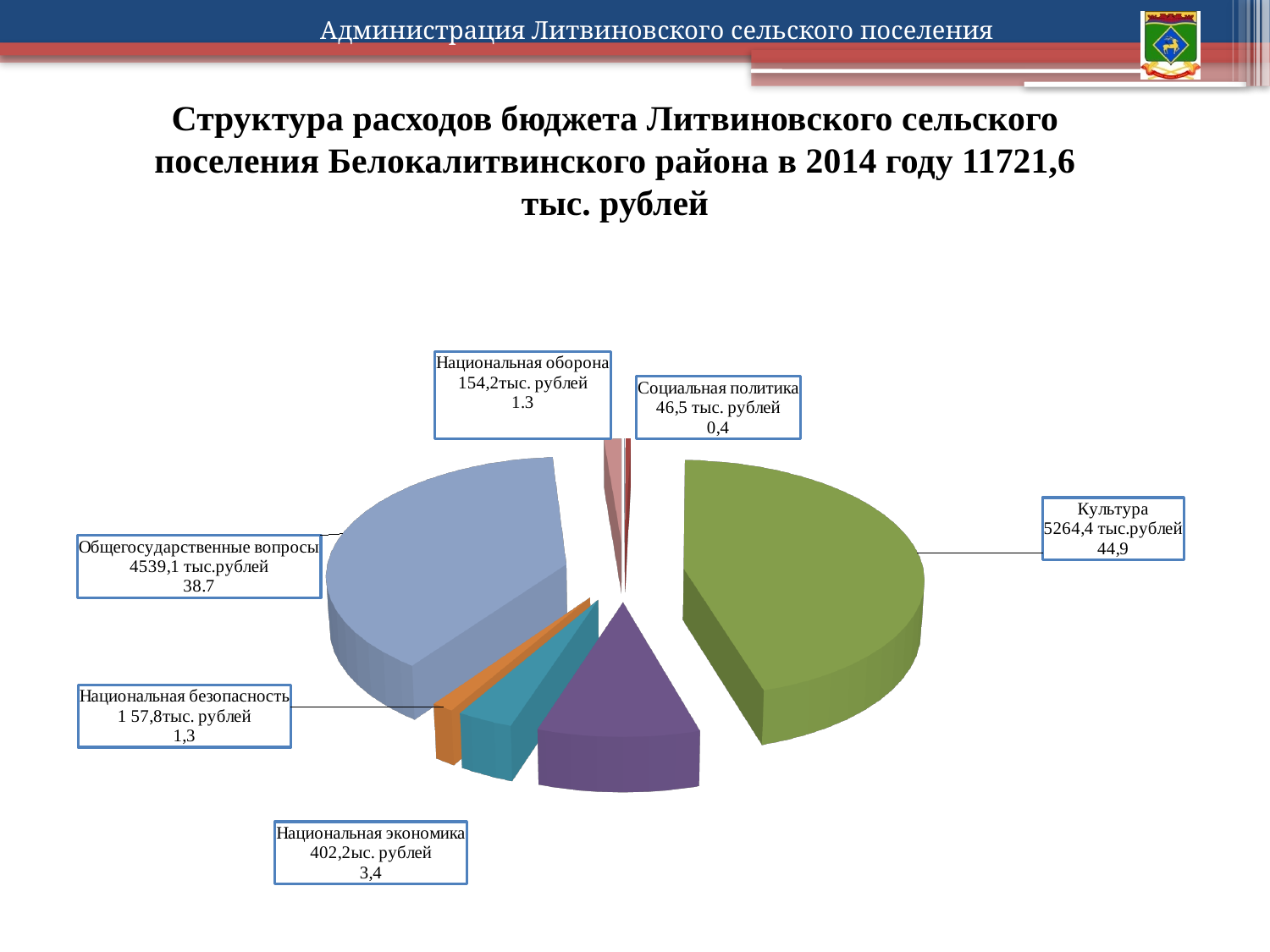
What is the value for Культура? 5264,4 тыс.рублей What kind of chart is shown on the slide? pie chart What is the value for Общегосударственные вопросы? 4539,1 тыс.рублей What share of the pie does Культура represent? 44,9 What is the value for Социальная политика? 46,5 тыс. рублей Which labelled category has the smallest value? Социальная политика What is the value for Национальная экономика? 402,2 тыс. рублей What is the difference between the values for Культура and Общегосударственные вопросы? 725,3 тыс.рублей What share of the pie does Общегосударственные вопросы represent? 38.7 Which labelled category has the largest value? Культура What is the value for Национальная оборона? 154,2 тыс. рублей Which is larger, Национальная экономика or Национальная оборона? Национальная экономика